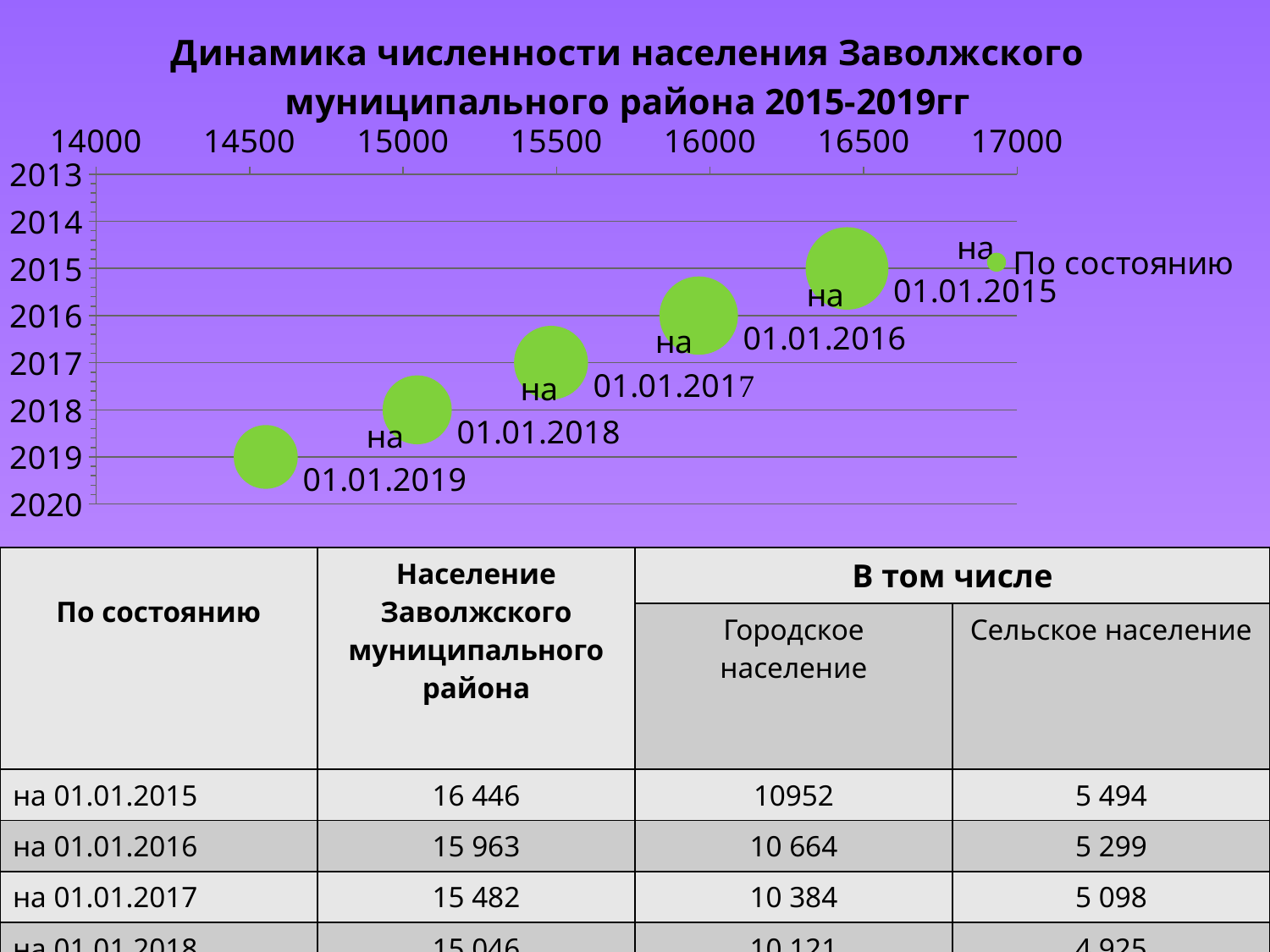
Which date has the highest population value on the chart? на 01.01.2015 What is the legend entry shown on the chart? По состоянию Is the value for на 01.01.2018 greater or less than 15500? less Is the value for на 01.01.2015 greater or less than 16000? greater Is the value for на 01.01.2019 greater or less than 15000? less Does the population value rise or fall from 01.01.2015 to 01.01.2019 on the chart? fall Which is larger, the population on 01.01.2016 or on 01.01.2018? 01.01.2016 How many bubbles (data points) are plotted on the chart? 5 According to the table under the chart, what is the population of the Zavolzhsky municipal district on 01.01.2015? 16 446 What kind of chart is shown on the slide? bubble chart Which date has the lowest population value on the chart? на 01.01.2019